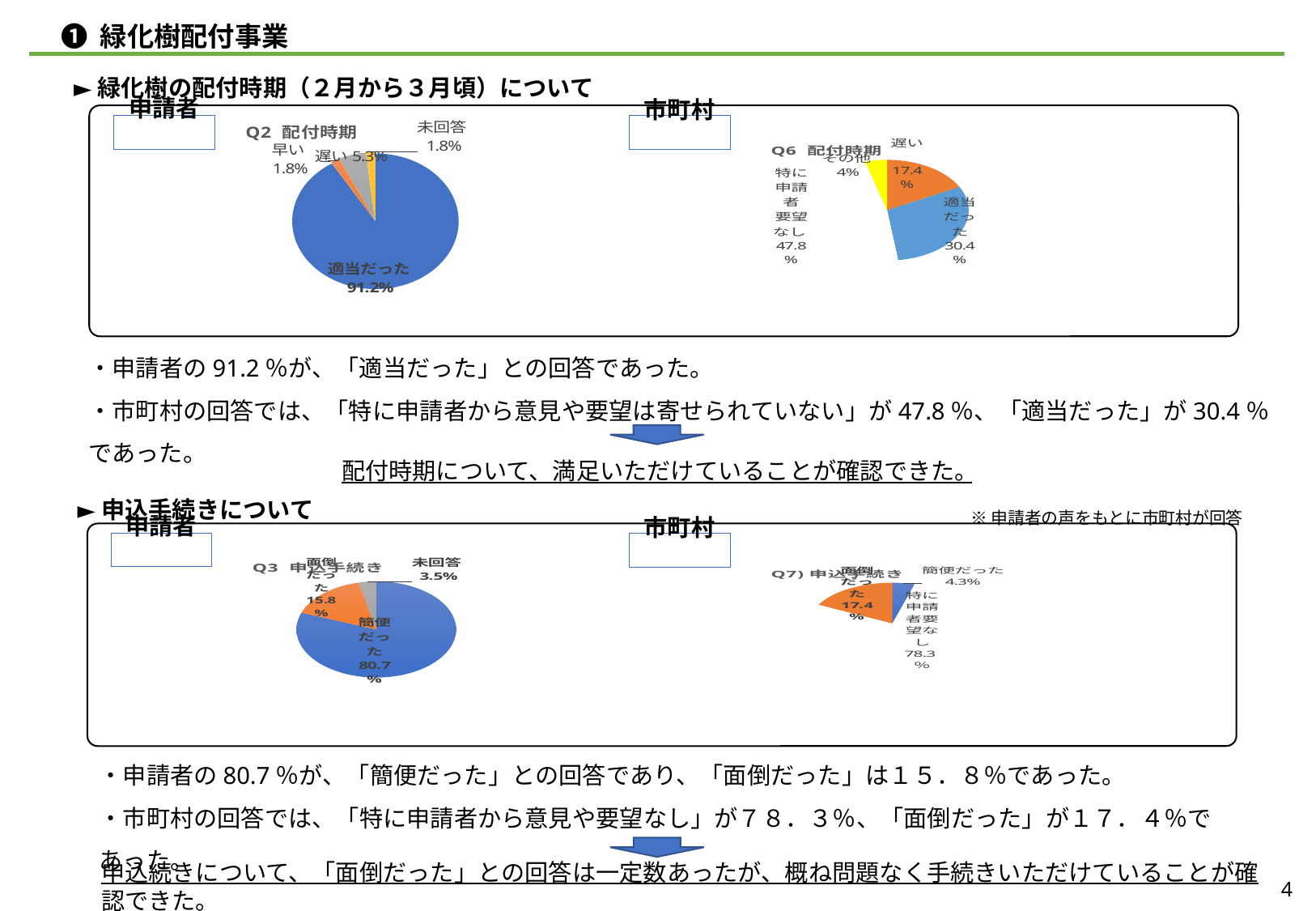
In the Q2 配付時期 pie chart, what share of respondents answered 適当だった? 91.2% In the Q6 配付時期 pie chart, what is the difference between 特に申請者要望なし and 適当だった? 17.4% In the Q2 配付時期 pie chart, what is the value for 遅い? 5.3% In the Q7) 申込手続き pie chart, what is the value for 簡便だった? 4.3% In the Q3 申込手続き pie chart, what share of respondents answered 簡便だった? 80.7% In the Q6 配付時期 pie chart, which category has the smallest share? その他 In the Q6 配付時期 pie chart, what is the value for 適当だった? 30.4% In the Q3 申込手続き pie chart, how many categories are shown? 3 In the Q7) 申込手続き pie chart, what is the value for 特に申請者要望なし? 78.3% What type of chart is the Q6 配付時期 chart? Pie chart In the Q2 配付時期 pie chart, which category has the largest share? 適当だった In the Q3 申込手続き pie chart, which is larger, 面倒だった or 未回答? 面倒だった